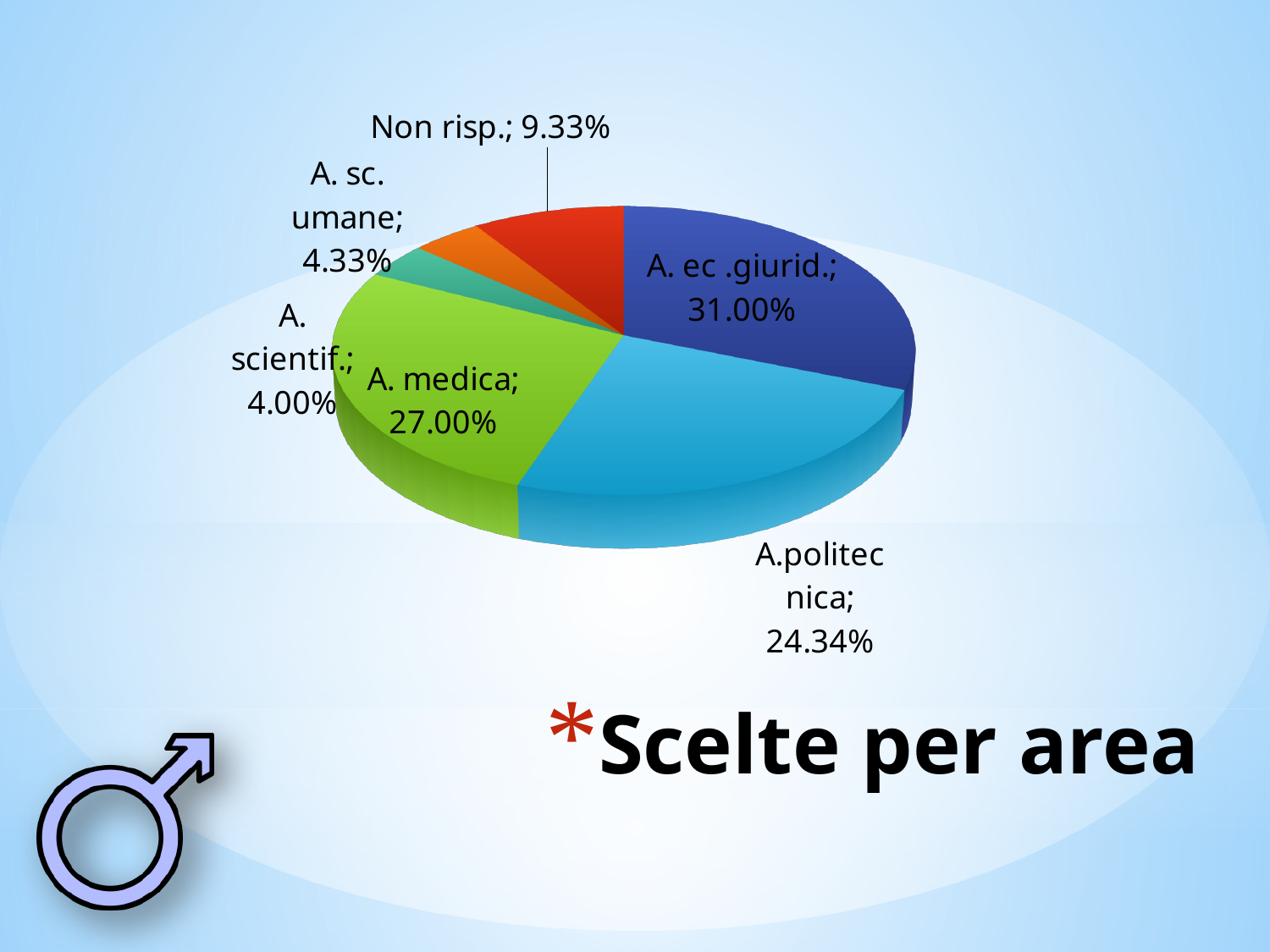
What is the title of the chart on the slide? Scelte per area What is the difference between the values for A. ec .giurid. and A. medica? 4.00% How many slices does the pie chart have? 6 What is the value for A.politecnica? 24.34% What is the value for A. medica? 27.00% What is the value for A. ec .giurid.? 31.00% Which is larger, the value for A. medica or the value for A.politecnica? A. medica What is the value for Non risp.? 9.33% What kind of chart is shown on the slide? pie chart Which category has the smallest share of the pie? A. scientif. Which category has the largest share of the pie? A. ec .giurid. What is the value for A. scientif.? 4.00%